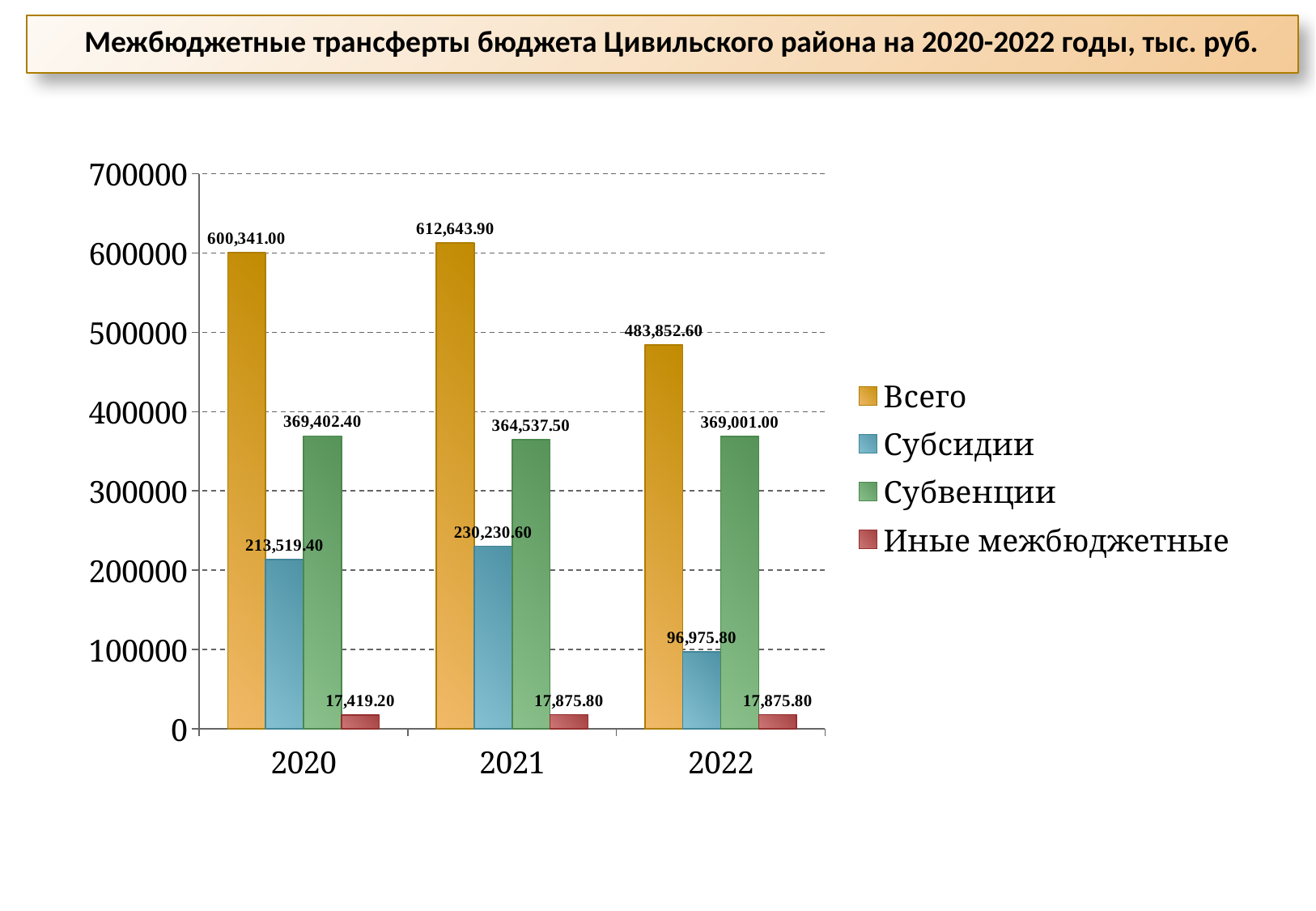
What is the value of Субвенции for 2020? 369,402.40 How many series does the legend list? 4 In which year is the Всего value highest? 2021 How many years are shown on the x axis? 3 In which year is the Субсидии value lowest? 2022 What is the value of Субсидии for 2022? 96,975.80 What is the difference between the Всего values for 2021 and 2020? 12,302.90 What is the difference between the Субсидии values for 2021 and 2022? 133,254.80 What is the value of Всего for 2021? 612,643.90 What is the value of Иные межбюджетные for 2021? 17,875.80 Which is larger: Субвенции in 2020 or Субвенции in 2021? Субвенции in 2020 What kind of chart is shown on the slide? Bar chart